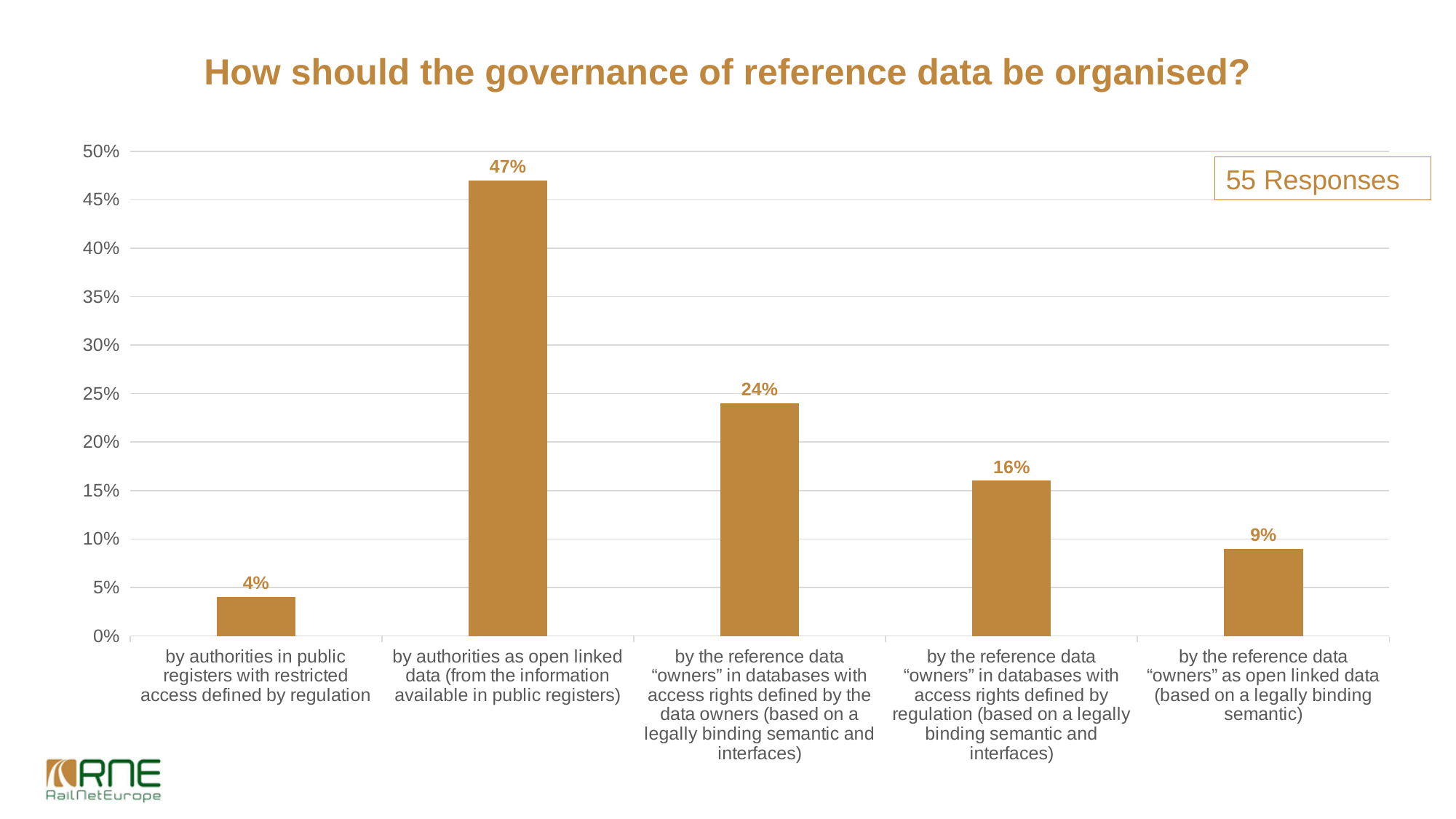
Which option received the highest share of responses? by authorities as open linked data (from the information available in public registers) What percentage is shown for 'by authorities in public registers with restricted access defined by regulation'? 4% Which is larger: the value for 'by the reference data "owners" in databases with access rights defined by regulation' or the value for 'by the reference data "owners" as open linked data'? by the reference data "owners" in databases with access rights defined by regulation How many responses does the chart say it is based on? 55 Responses How many categories are shown on the x axis of the chart? 5 What is the value for 'by the reference data "owners" as open linked data (based on a legally binding semantic)'? 9% Which option received the lowest share of responses? by authorities in public registers with restricted access defined by regulation What is the title of the chart? How should the governance of reference data be organised? What is the value for 'by the reference data "owners" in databases with access rights defined by the data owners (based on a legally binding semantic and interfaces)'? 24% What kind of chart is shown on the slide? bar chart What percentage of respondents chose 'by authorities as open linked data (from the information available in public registers)'? 47% What is the difference between the value for 'by authorities as open linked data' and the value for 'by the reference data "owners" in databases with access rights defined by the data owners'? 23%